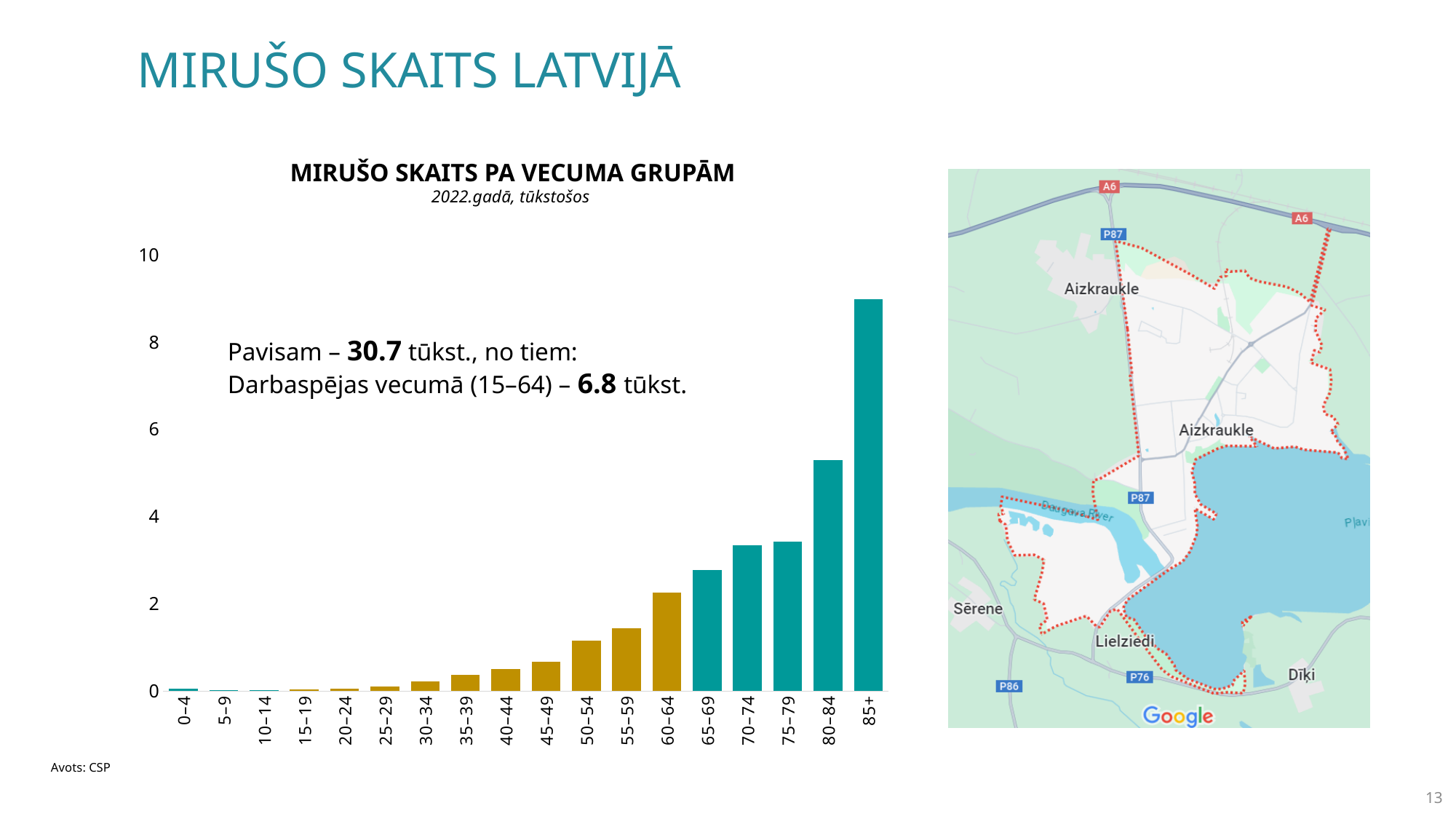
What kind of chart is shown on the slide? bar chart How many age groups are shown on the x axis of the chart? 18 Is the value for the 75–79 age group greater or less than 4? less Which is larger, the value for 80–84 or the value for 85+? 85+ Is the value for the 85+ age group greater or less than 8? greater Is the value for the 80–84 age group greater or less than 4? greater What is the title of the chart? MIRUŠO SKAITS PA VECUMA GRUPĀM Do the values generally rise or fall as the age groups increase along the x axis? rise Which is larger, the value for 50–54 or the value for 65–69? 65–69 Which age group has the highest number of deaths in the chart? 85+